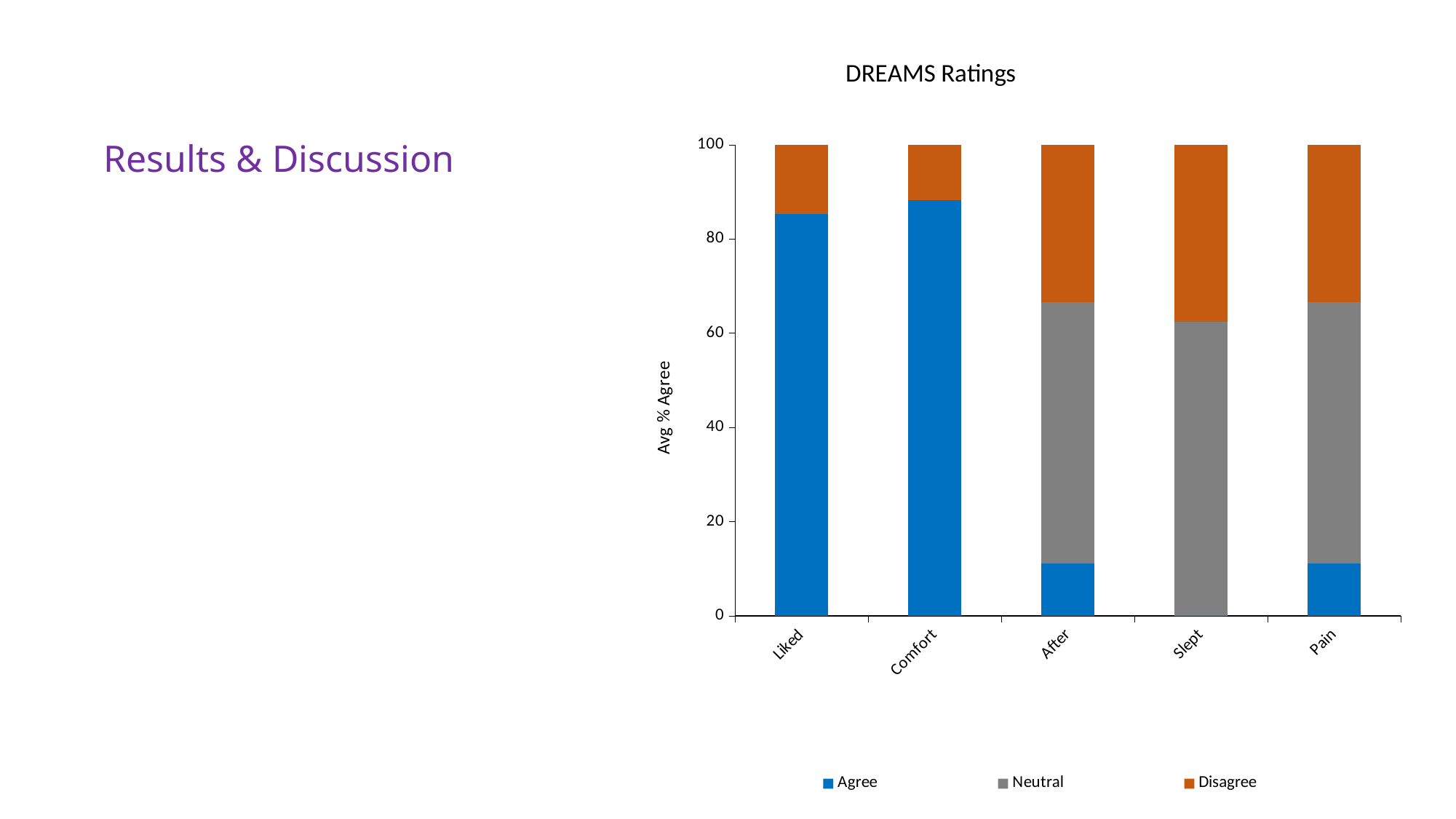
Is the Agree value for Liked greater or less than 80? greater Which is larger, the Disagree segment for Slept or the Disagree segment for Comfort? Slept What is the label on the vertical axis of the chart? Avg % Agree What kind of chart is shown on the slide? Stacked bar chart How many series does the legend of the DREAMS Ratings chart list? 3 Which category has the largest Neutral segment? Slept What is the total height of the stacked bar for Pain? 100 How many categories are shown on the x axis of the DREAMS Ratings chart? 5 What is the title of the chart? DREAMS Ratings Is the Agree value for After greater or less than 20? less Which category has the smallest Agree segment? Slept Is the Neutral value for Slept greater or less than 60? greater